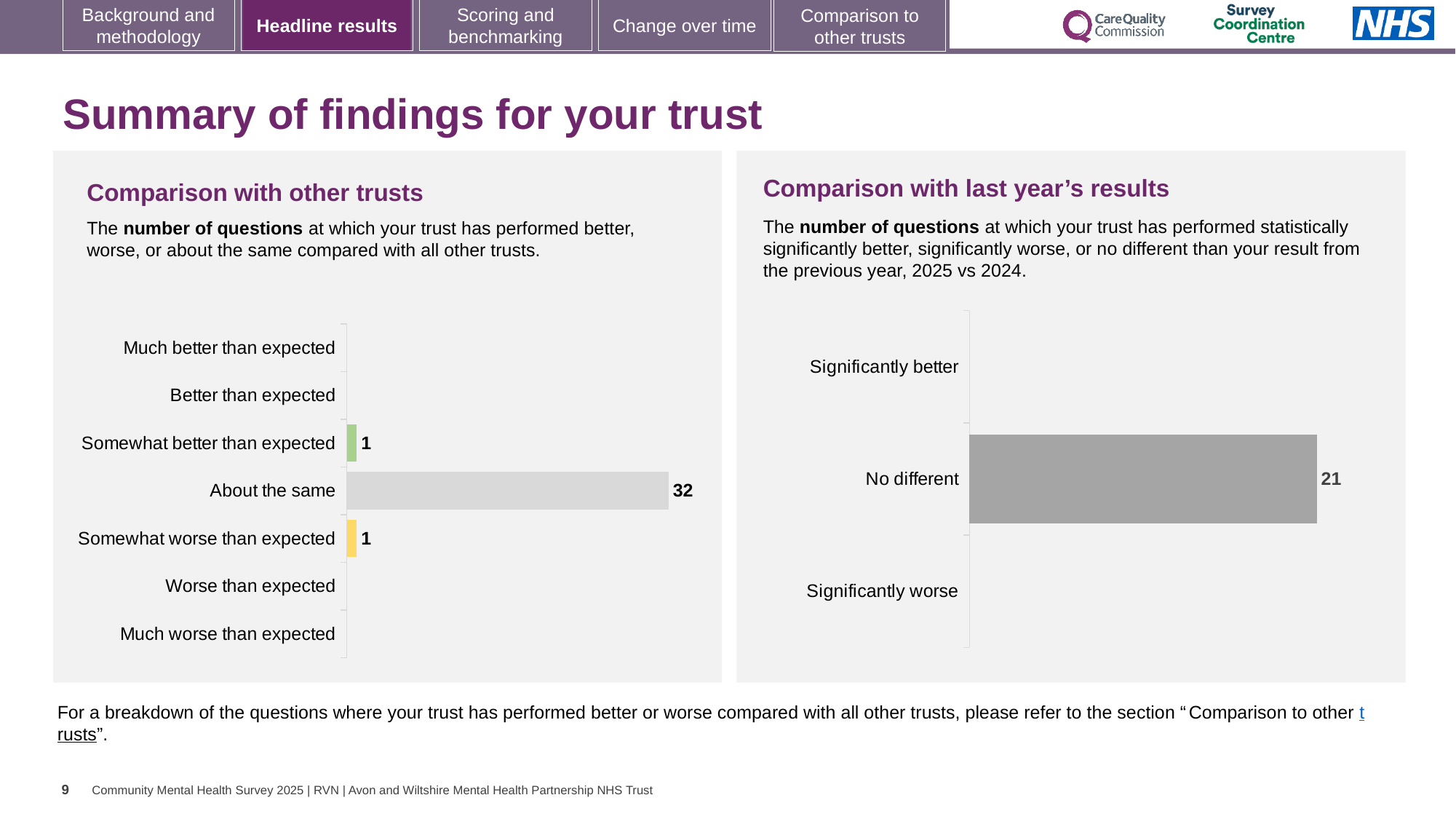
In the 'Comparison with other trusts' chart, what is the value for 'Somewhat better than expected'? 1 How many categories are listed on the 'Comparison with last year's results' chart? 3 In the 'Comparison with other trusts' chart, which category has the highest value? About the same In the 'Comparison with other trusts' chart, which is larger: the value for 'About the same' or the value for 'Somewhat worse than expected'? About the same In the 'Comparison with other trusts' chart, what is the value for 'Somewhat worse than expected'? 1 How many categories are listed on the 'Comparison with other trusts' chart? 7 In the 'Comparison with other trusts' chart, what is the value for 'About the same'? 32 In the 'Comparison with last year's results' chart, what is the value for 'No different'? 21 What is the title of the chart on the left side of the slide? Comparison with other trusts In the 'Comparison with other trusts' chart, what is the difference between the values for 'About the same' and 'Somewhat better than expected'? 31 In the 'Comparison with last year's results' chart, which category has the highest value? No different What kind of chart is the 'Comparison with last year's results' chart? Bar chart